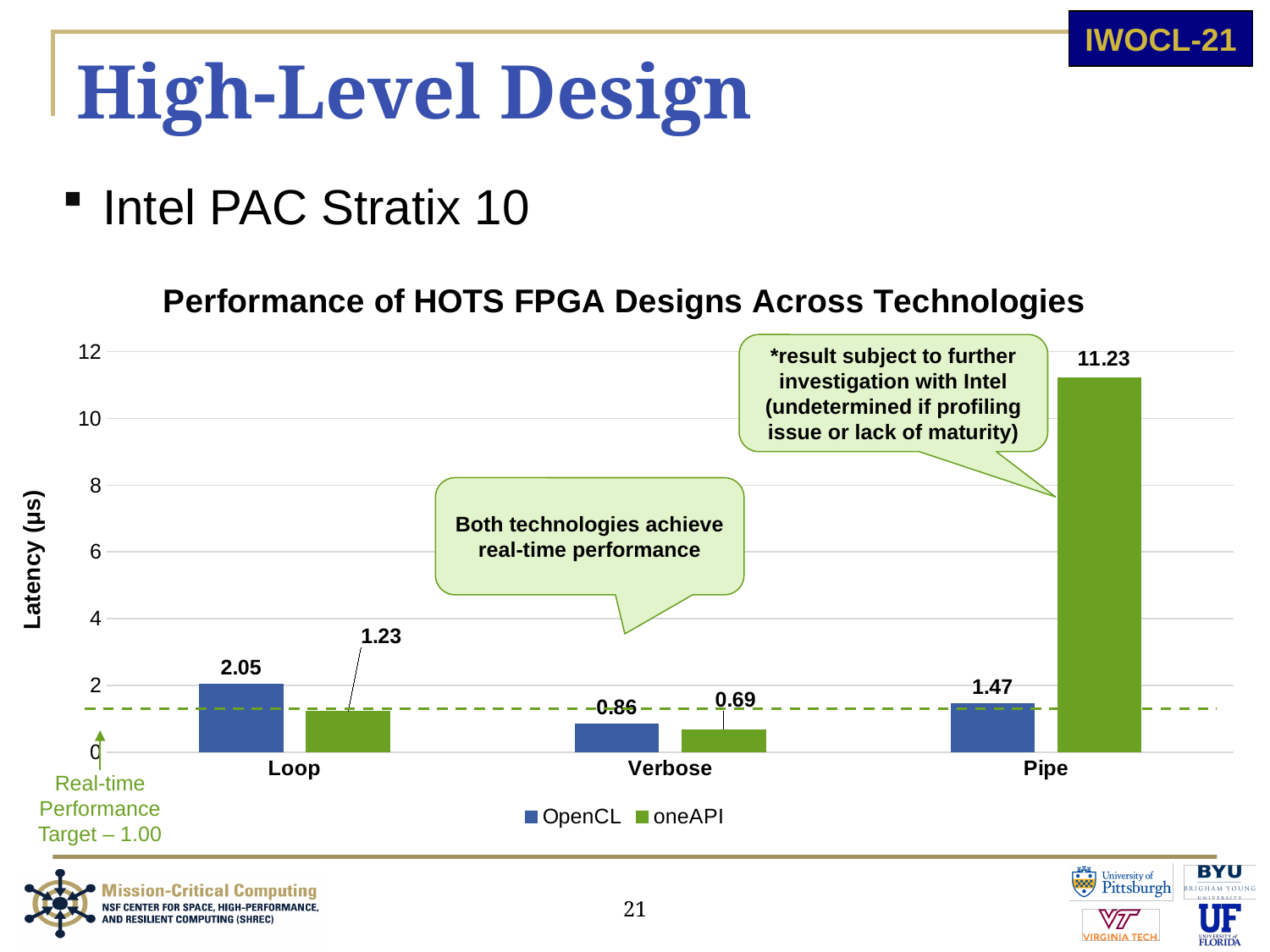
What is the OpenCL latency for the Loop design? 2.05 Which design has the lowest OpenCL latency? Verbose What is the difference between the OpenCL and oneAPI latencies for the Loop design? 0.82 What is the label of the y axis? Latency (µs) What is the oneAPI latency for the Verbose design? 0.69 What is the OpenCL latency for the Pipe design? 1.47 How many designs are shown on the x axis? 3 What is the oneAPI latency for the Pipe design? 11.23 Which design has the highest oneAPI latency? Pipe For the Pipe design, which technology has the higher latency, OpenCL or oneAPI? oneAPI What kind of chart is shown on the slide? Bar chart How many series does the legend list? 2